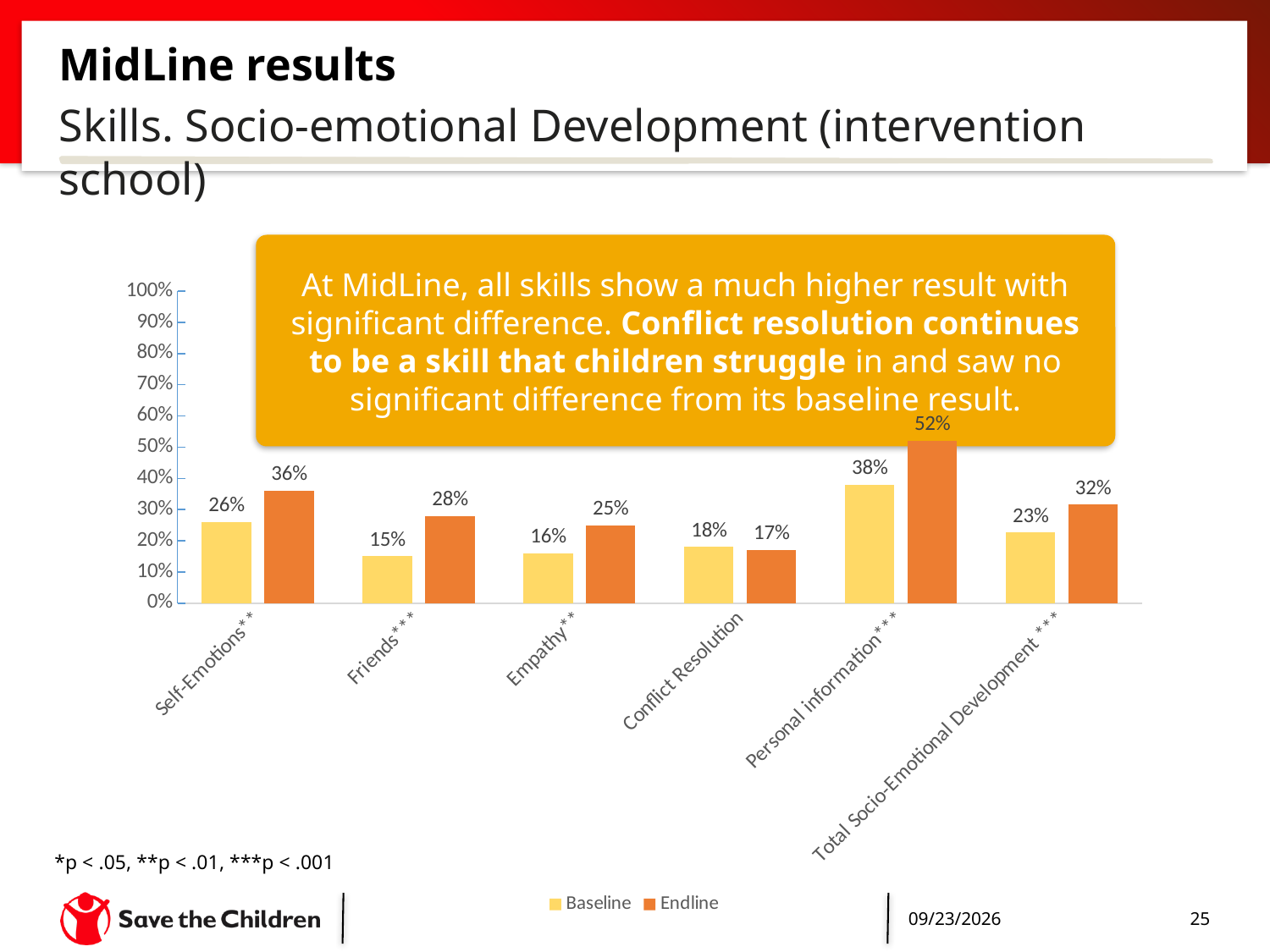
Is the Endline value for Personal information greater or less than 50%? greater What is the Endline value for Conflict Resolution? 17% What is the Baseline value for Total Socio-Emotional Development? 23% Which category has the lowest Baseline value? Friends What kind of chart is shown on the slide? bar chart How many categories are shown on the x axis? 6 Which is larger for Conflict Resolution, the Baseline value or the Endline value? Baseline What is the Endline value for Personal information? 52% What is the Baseline value for Self-Emotions? 26% Which category has the highest Endline value? Personal information How many series does the legend list? 2 What is the difference between the Endline and Baseline values for Friends? 13%